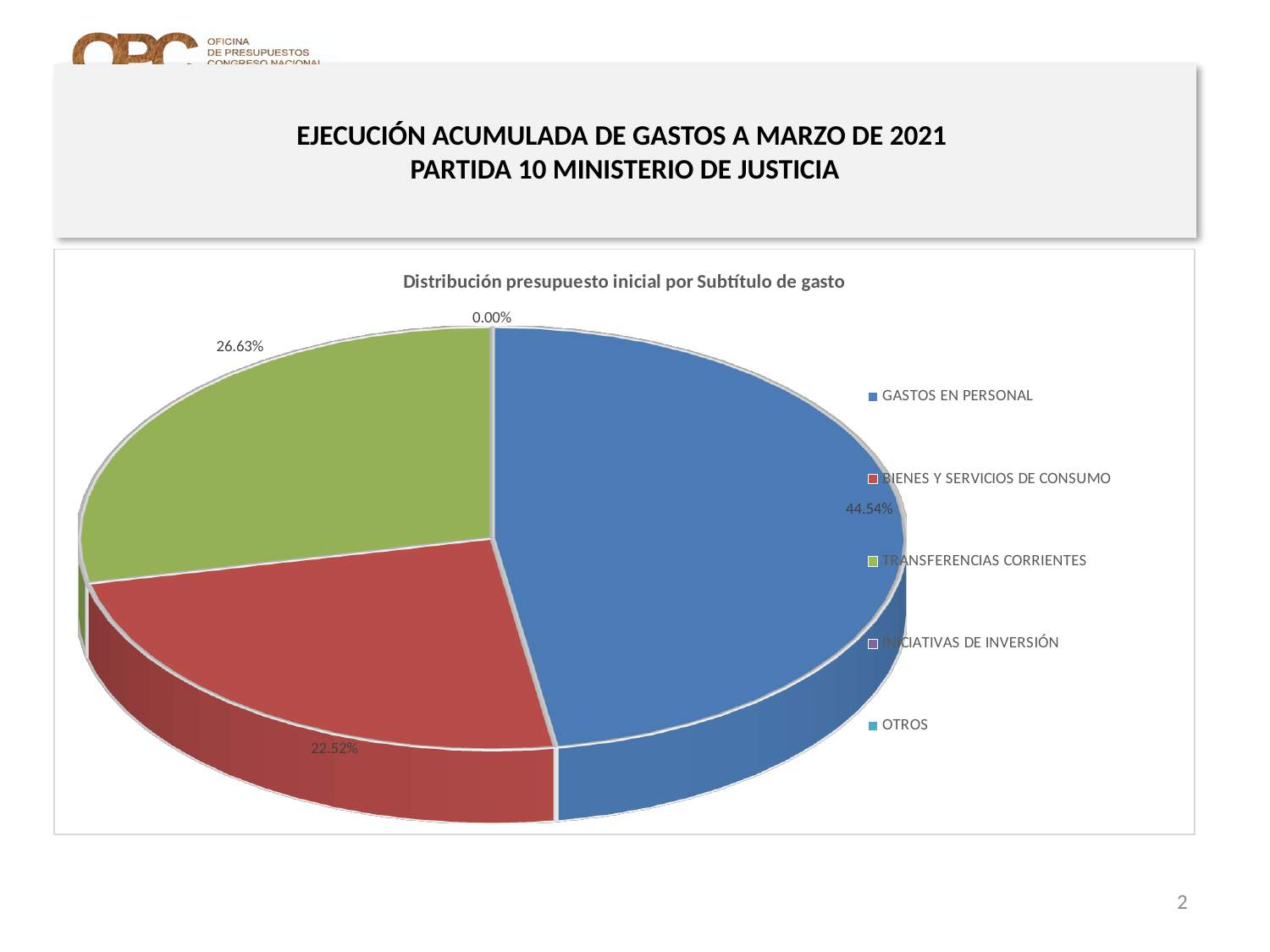
What share of the pie does TRANSFERENCIAS CORRIENTES represent? 26.63% What share of the pie does BIENES Y SERVICIOS DE CONSUMO represent? 22.52% What is the difference in percentage points between the TRANSFERENCIAS CORRIENTES share and the BIENES Y SERVICIOS DE CONSUMO share? 4.11 Which category has the largest share of the pie? GASTOS EN PERSONAL What kind of chart is shown on the slide? pie chart What colour is the slice for GASTOS EN PERSONAL? blue What is the title of the chart? Distribución presupuesto inicial por Subtítulo de gasto What is the difference in percentage points between the GASTOS EN PERSONAL share and the BIENES Y SERVICIOS DE CONSUMO share? 22.02 How many entries does the chart legend list? 5 Which is larger, the share for TRANSFERENCIAS CORRIENTES or the share for BIENES Y SERVICIOS DE CONSUMO? TRANSFERENCIAS CORRIENTES Is the share for GASTOS EN PERSONAL greater or less than 40%? greater What share of the pie does GASTOS EN PERSONAL represent? 44.54%